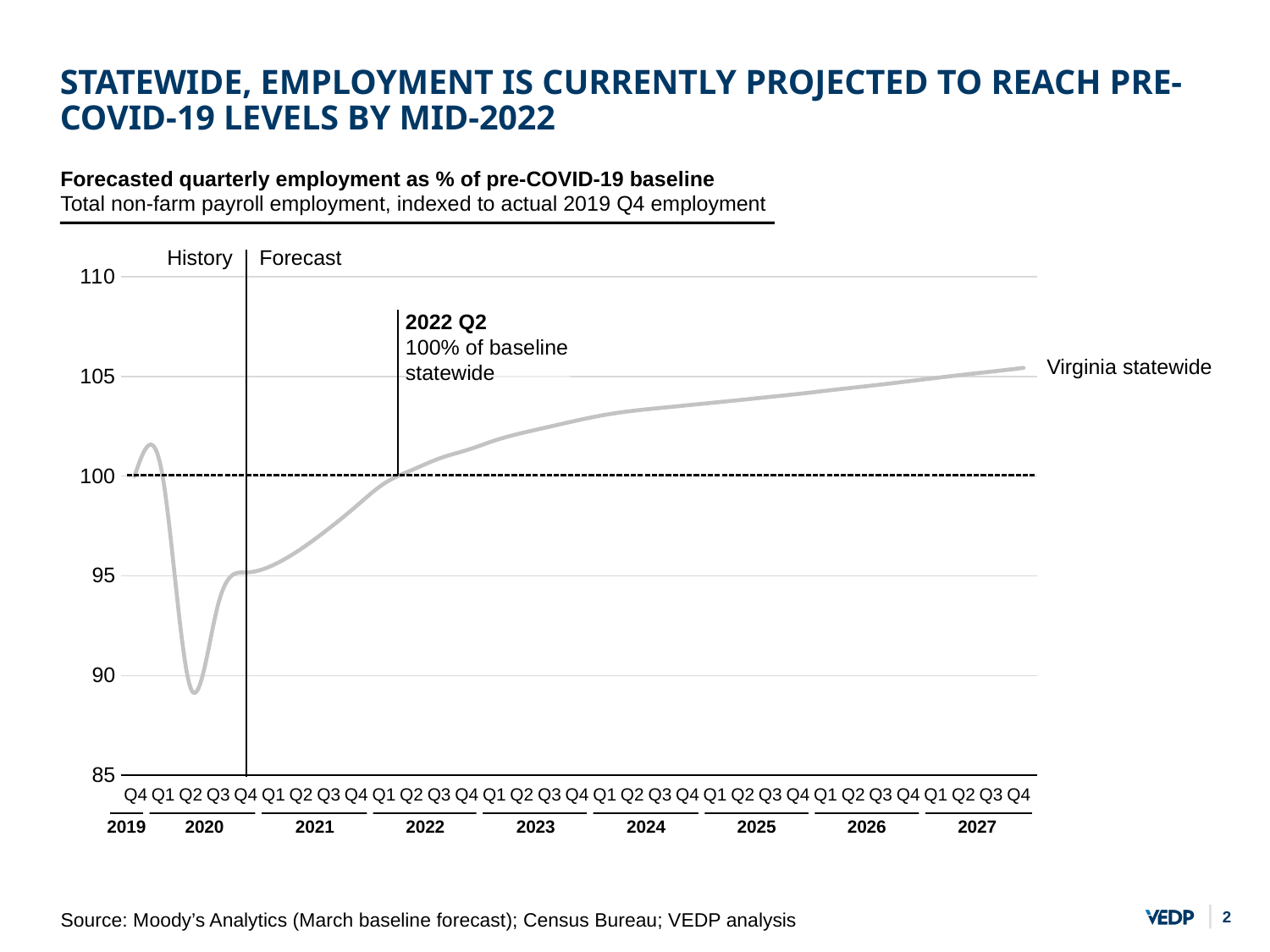
Does the line rise or fall from 2021 Q1 to 2027 Q4? rises What kind of chart is shown on the slide? line chart In which quarter does the line reach its highest point? 2027 Q4 In which quarter does the line reach its lowest point? 2020 Q2 What is the name of the series plotted on the chart? Virginia statewide How many years are labeled on the x axis? 9 How many series does the chart plot? 1 According to the annotation, what percentage of baseline does statewide employment reach in 2022 Q2? 100% Is the value for 2020 Q2 greater or less than 90? less Is the value for 2024 Q1 greater or less than 100? greater Is the value for 2027 Q4 greater or less than 105? greater